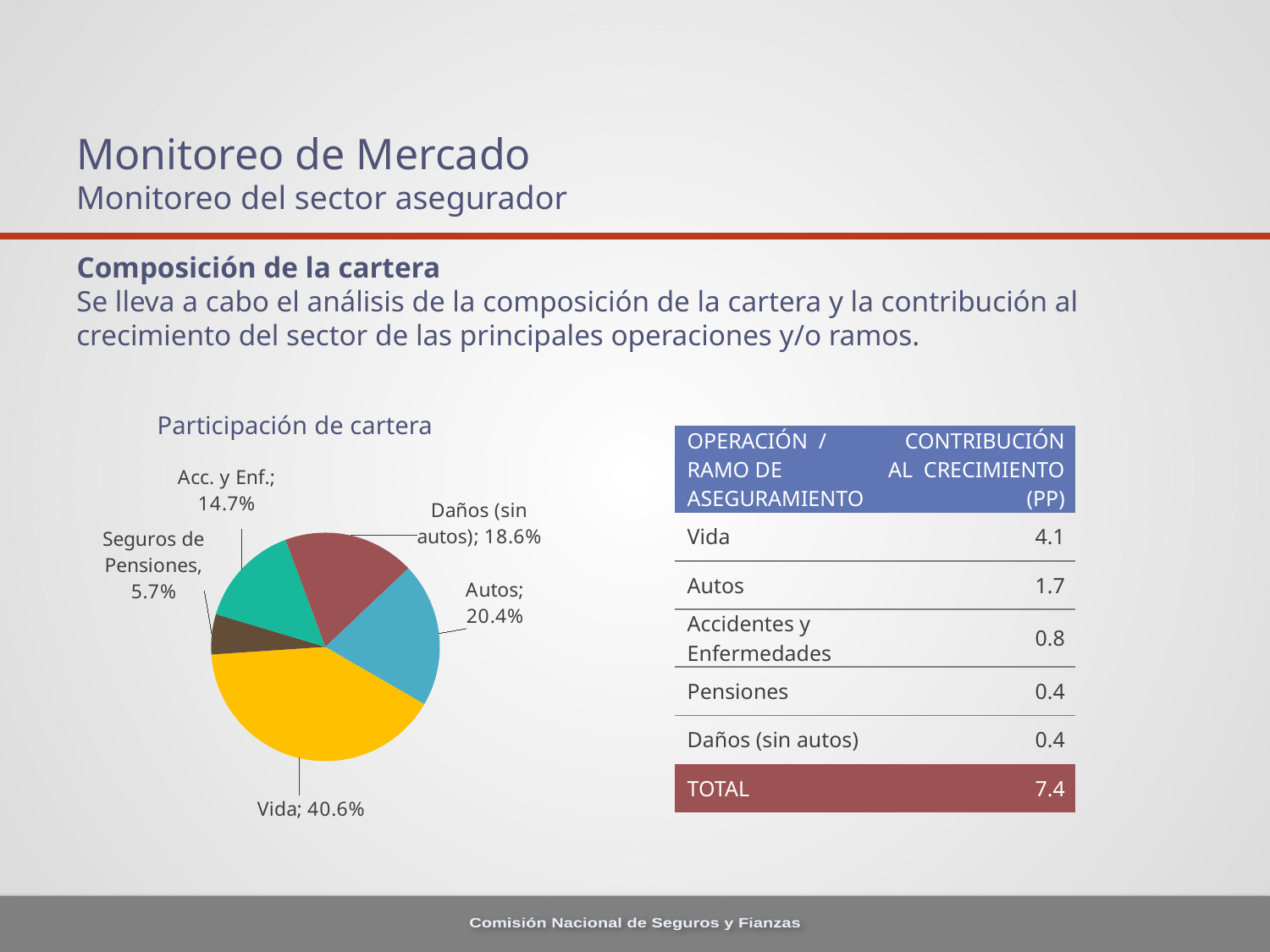
Which is larger, the share for Autos or the share for Daños (sin autos)? Autos What share of the pie does Acc. y Enf. have? 14.7% Which slice of the pie is the smallest? Seguros de Pensiones What share of the pie does Daños (sin autos) have? 18.6% What kind of chart is shown on the slide? Pie chart Which slice of the pie is the largest? Vida What share of the pie does Seguros de Pensiones have? 5.7% What is the difference between the share for Vida and the share for Autos? 20.2% What share of the pie does Autos have? 20.4% How many slices does the pie chart have? 5 What share of the pie does Vida have? 40.6% What is the title of the chart? Participación de cartera